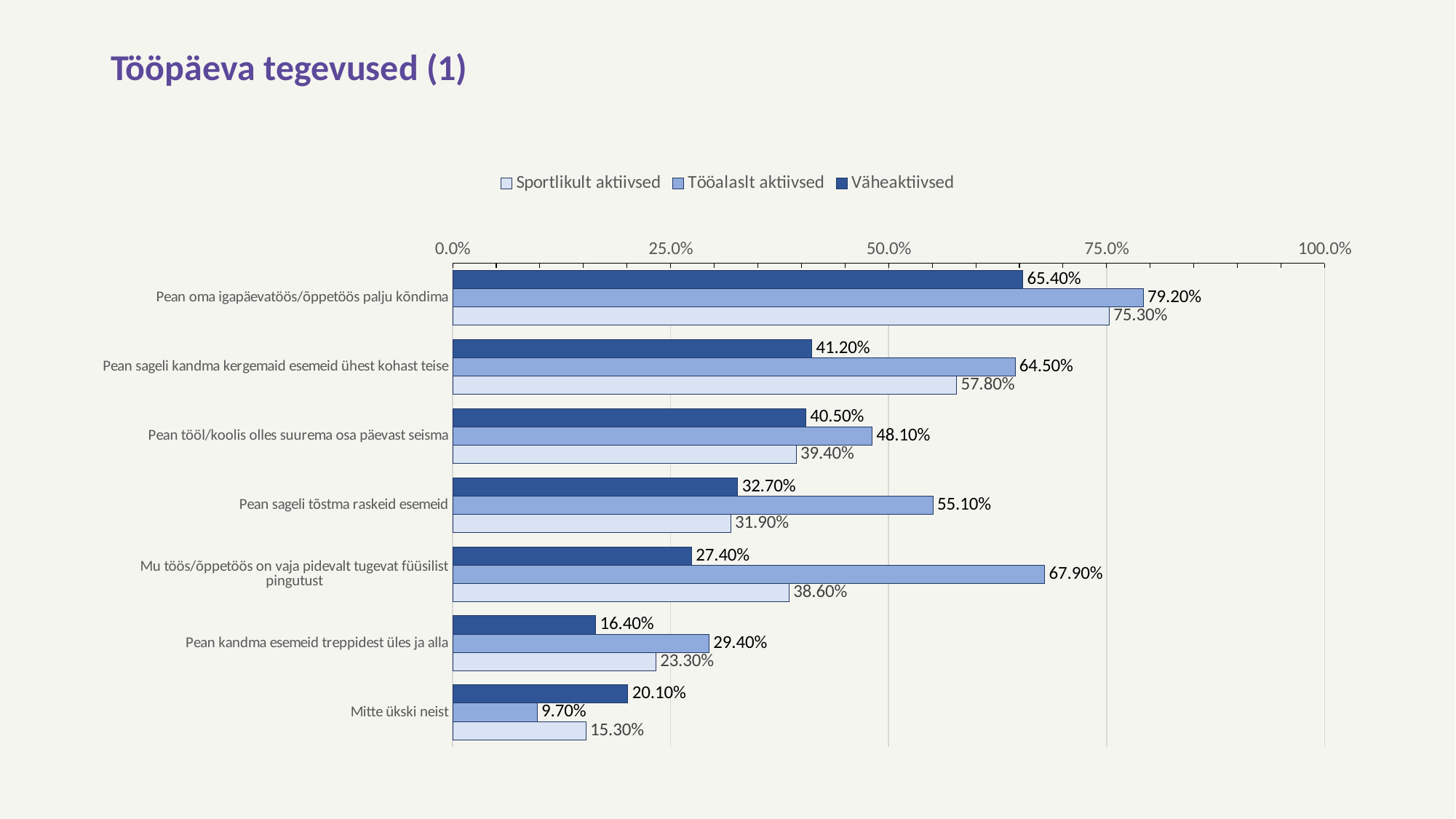
Is the value for Sportlikult aktiivsed in "Pean sageli kandma kergemaid esemeid ühest kohast teise" greater or less than 50.0%? greater Which category has the lowest value for Tööalaslt aktiivsed? Mitte ükski neist What is the title of the slide? Tööpäeva tegevused (1) In the category "Pean sageli tõstma raskeid esemeid", which series has the larger value: Sportlikult aktiivsed or Tööalaslt aktiivsed? Tööalaslt aktiivsed What is the value for Väheaktiivsed in the category "Mitte ükski neist"? 20.10% How many categories are shown on the chart? 7 What is the difference between the Tööalaslt aktiivsed and Väheaktiivsed values for "Mu töös/õppetöös on vaja pidevalt tugevat füüsilist pingutust"? 40.50% What is the value for Sportlikult aktiivsed in the category "Mu töös/õppetöös on vaja pidevalt tugevat füüsilist pingutust"? 38.60% Which category has the highest value for Väheaktiivsed? Pean oma igapäevatöös/õppetöös palju kõndima What is the value for Tööalaslt aktiivsed in the category "Pean oma igapäevatöös/õppetöös palju kõndima"? 79.20% How many series does the legend list? 3 What kind of chart is shown on the slide? bar chart